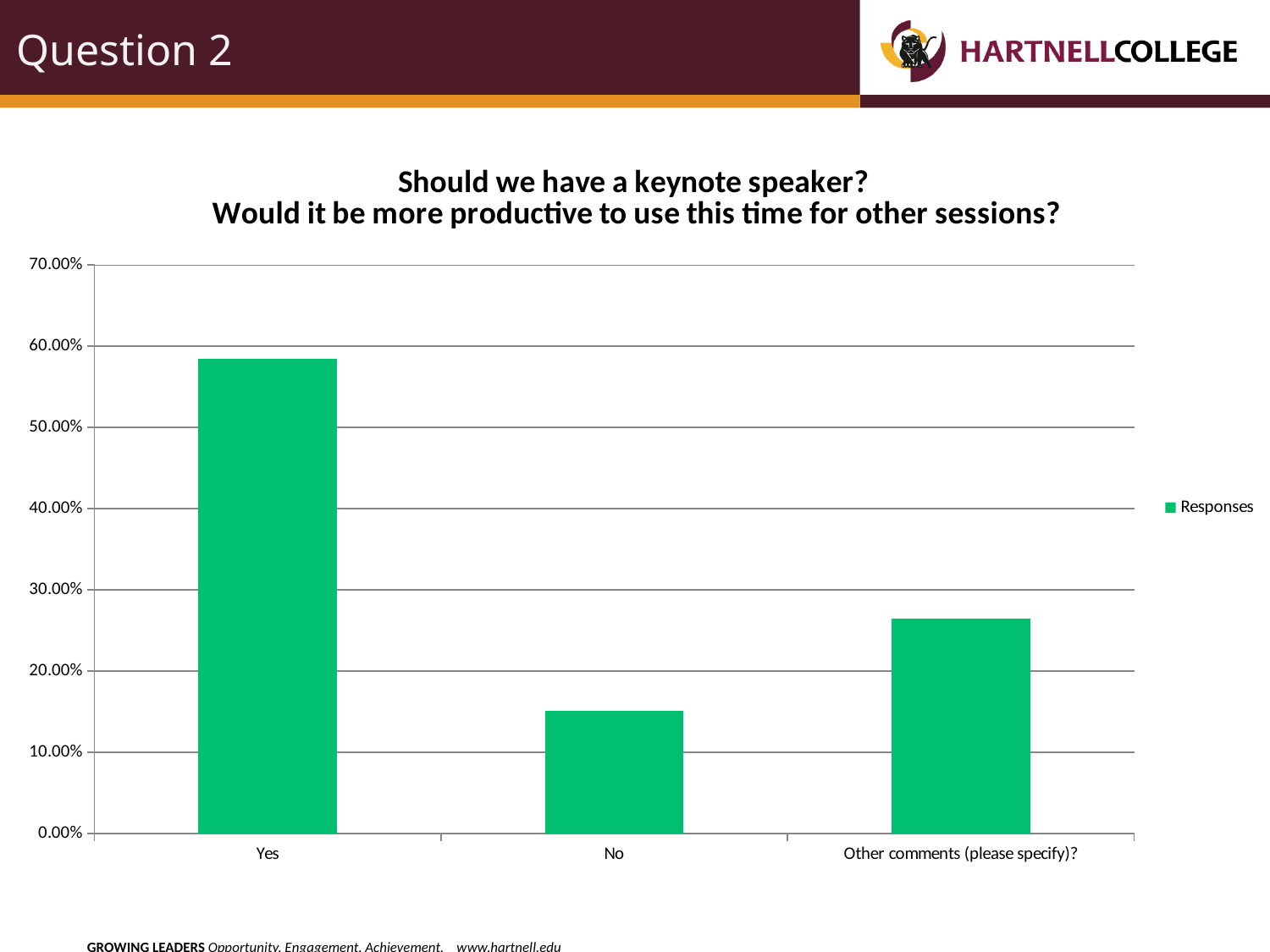
How many series does the legend list? 1 Is the value for No greater or less than 20.00%? less Is the value for Other comments (please specify)? greater or less than 20.00%? greater How many categories are shown on the x axis? 3 Which category has the highest value? Yes Is the value for Yes greater or less than 50.00%? greater What kind of chart is shown on the slide? bar chart Which is larger, the value for No or the value for Other comments (please specify)? Other comments (please specify)? Which category has the lowest value? No